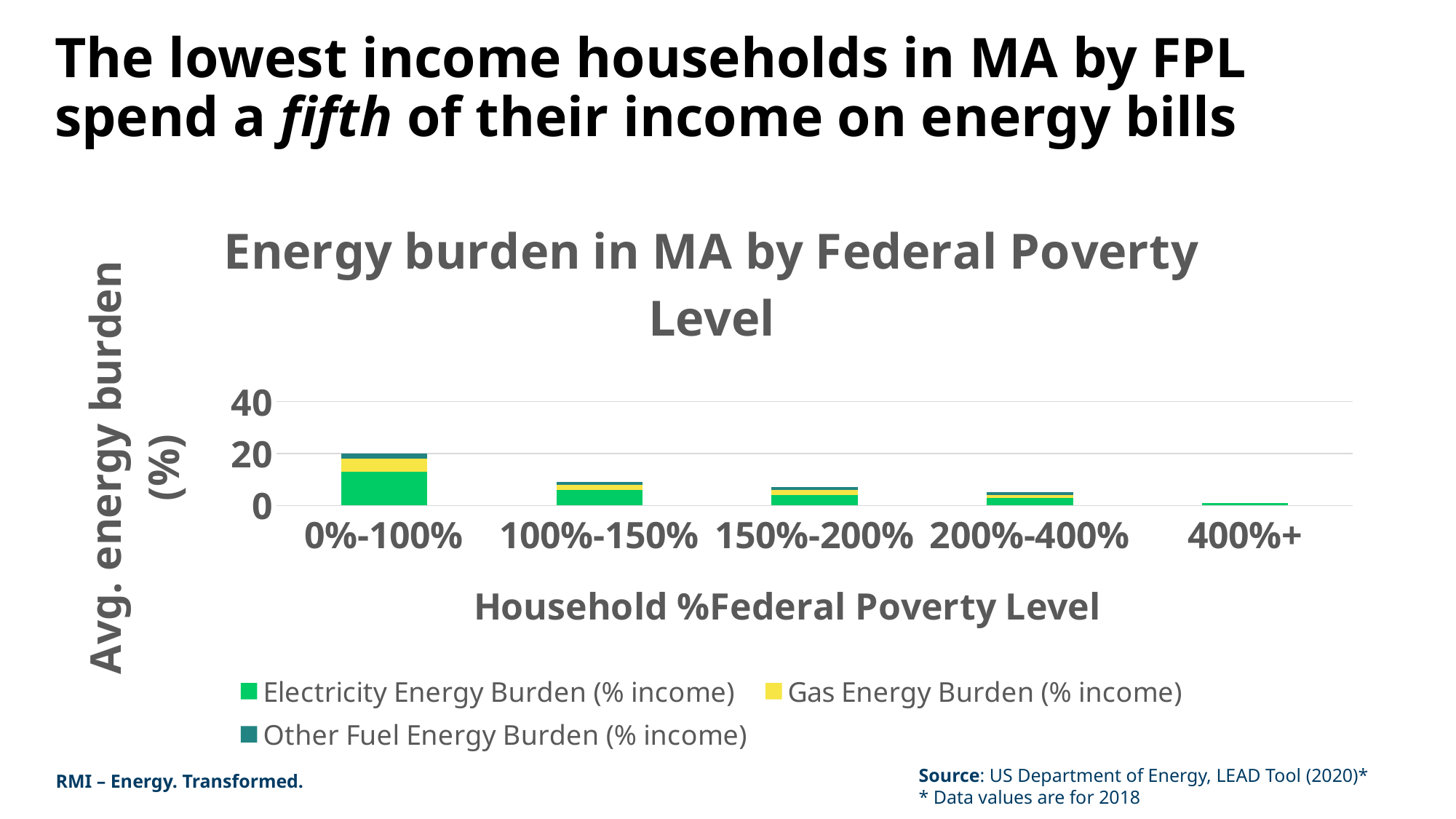
How many series does the legend list? 3 How many household Federal Poverty Level categories are shown on the x axis? 5 What is the label of the y axis? Avg. energy burden (%) Which series is shown in yellow in the legend? Gas Energy Burden (% income) Is the total energy burden for the 400%+ category greater or less than 20? less Is the total energy burden for the 100%-150% category greater or less than 20? less What kind of chart is shown on the slide? Stacked bar chart Which Federal Poverty Level category has the lowest total energy burden? 400%+ Which Federal Poverty Level category has the highest total energy burden? 0%-100% Do the total energy burden values rise or fall as the Federal Poverty Level increases along the x axis? fall What is the title of the chart? Energy burden in MA by Federal Poverty Level Which has a larger total energy burden, the 0%-100% category or the 200%-400% category? 0%-100%